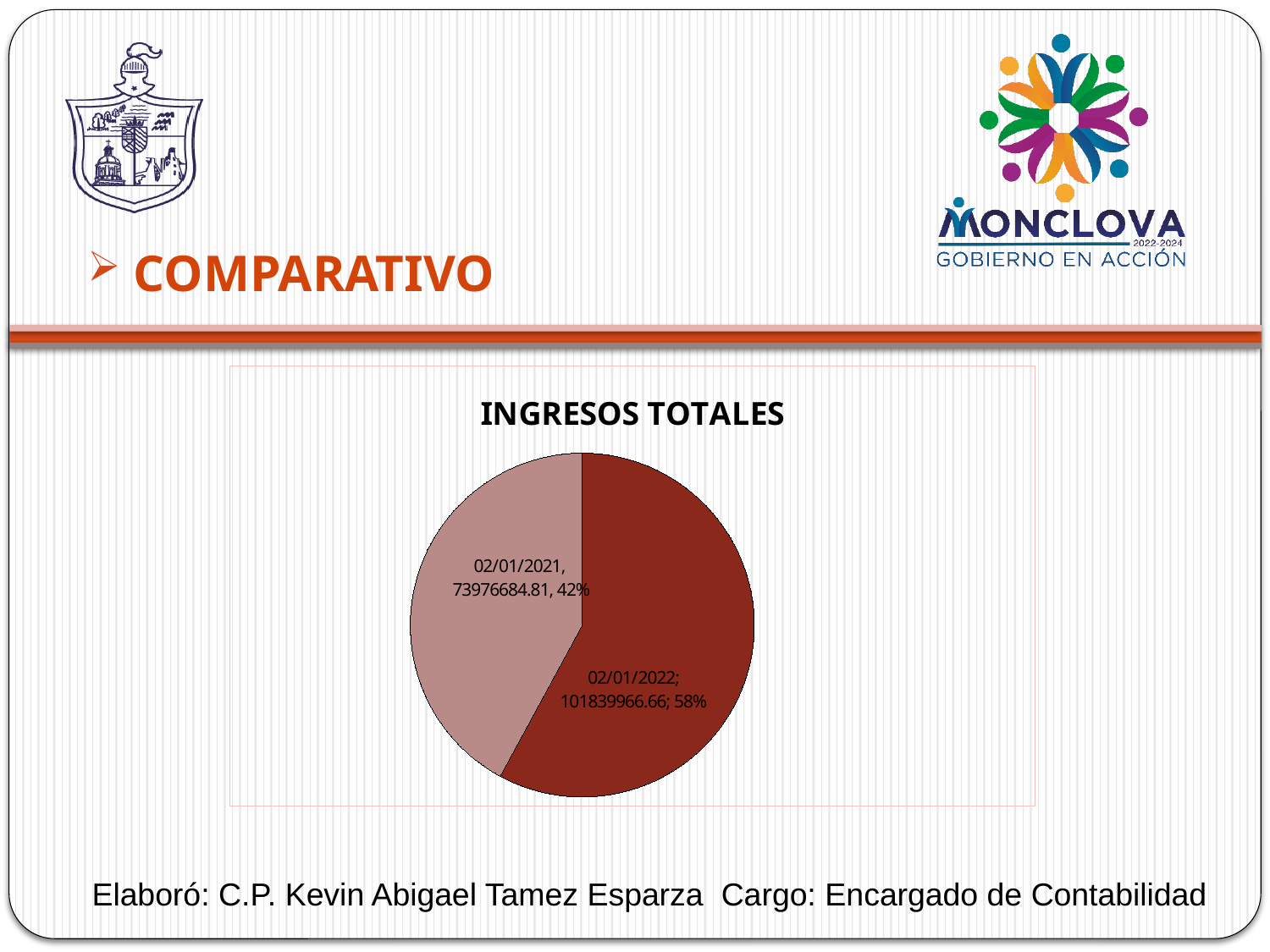
What is the title of the chart? INGRESOS TOTALES Which slice is the largest? 02/01/2022 How many slices does the pie chart have? 2 What is the difference between the values for 02/01/2022 and 02/01/2021? 27863281.85 What is the value for 02/01/2021? 73976684.81 What is the value for 02/01/2022? 101839966.66 What colour is the slice for 02/01/2022? dark red Which slice is the smallest? 02/01/2021 Which is larger, the value for 02/01/2021 or 02/01/2022? 02/01/2022 What share of the pie does 02/01/2022 represent? 58% What share of the pie does 02/01/2021 represent? 42% What kind of chart is shown on the slide? pie chart